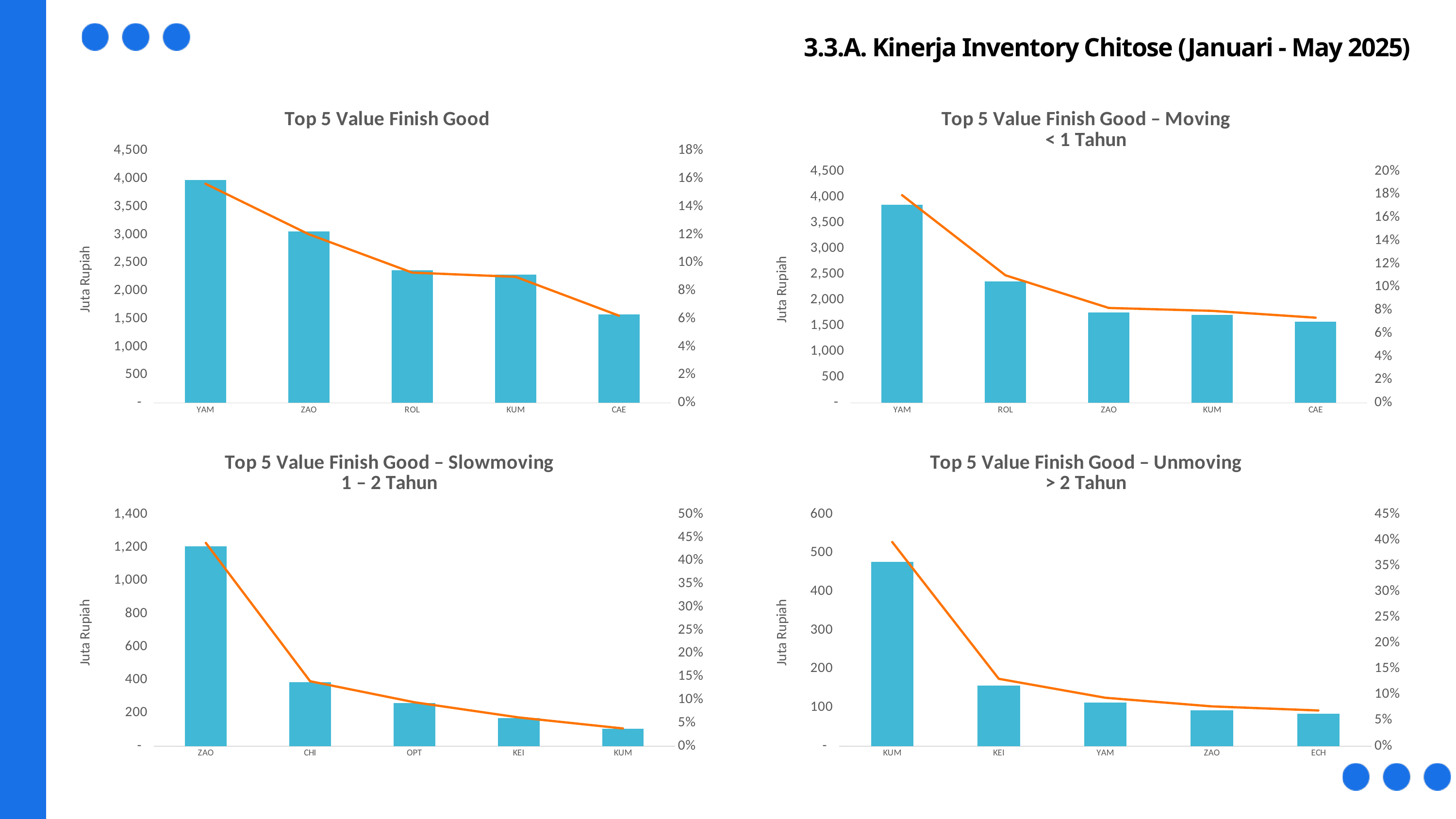
In the 'Top 5 Value Finish Good – Slowmoving 1 – 2 Tahun' chart (bottom left), is the bar for ZAO greater or less than 1,000? greater In the 'Top 5 Value Finish Good' chart (top left), which category has the highest bar? YAM In the 'Top 5 Value Finish Good' chart (top left), is the bar for ZAO greater or less than 3,000? greater In the 'Top 5 Value Finish Good – Moving < 1 Tahun' chart (top right), which category has the highest bar? YAM In the 'Top 5 Value Finish Good – Moving < 1 Tahun' chart (top right), which bar is taller, YAM or ROL? YAM How many categories are shown on the x axis of the 'Top 5 Value Finish Good – Unmoving > 2 Tahun' chart (bottom right)? 5 In the 'Top 5 Value Finish Good' chart (top left), which category has the lowest bar? CAE In the 'Top 5 Value Finish Good – Unmoving > 2 Tahun' chart (bottom right), which category has the lowest bar? ECH In the 'Top 5 Value Finish Good – Slowmoving 1 – 2 Tahun' chart (bottom left), which category has the highest bar? ZAO In the 'Top 5 Value Finish Good – Moving < 1 Tahun' chart (top right), is the bar for ROL greater or less than 2,000? greater